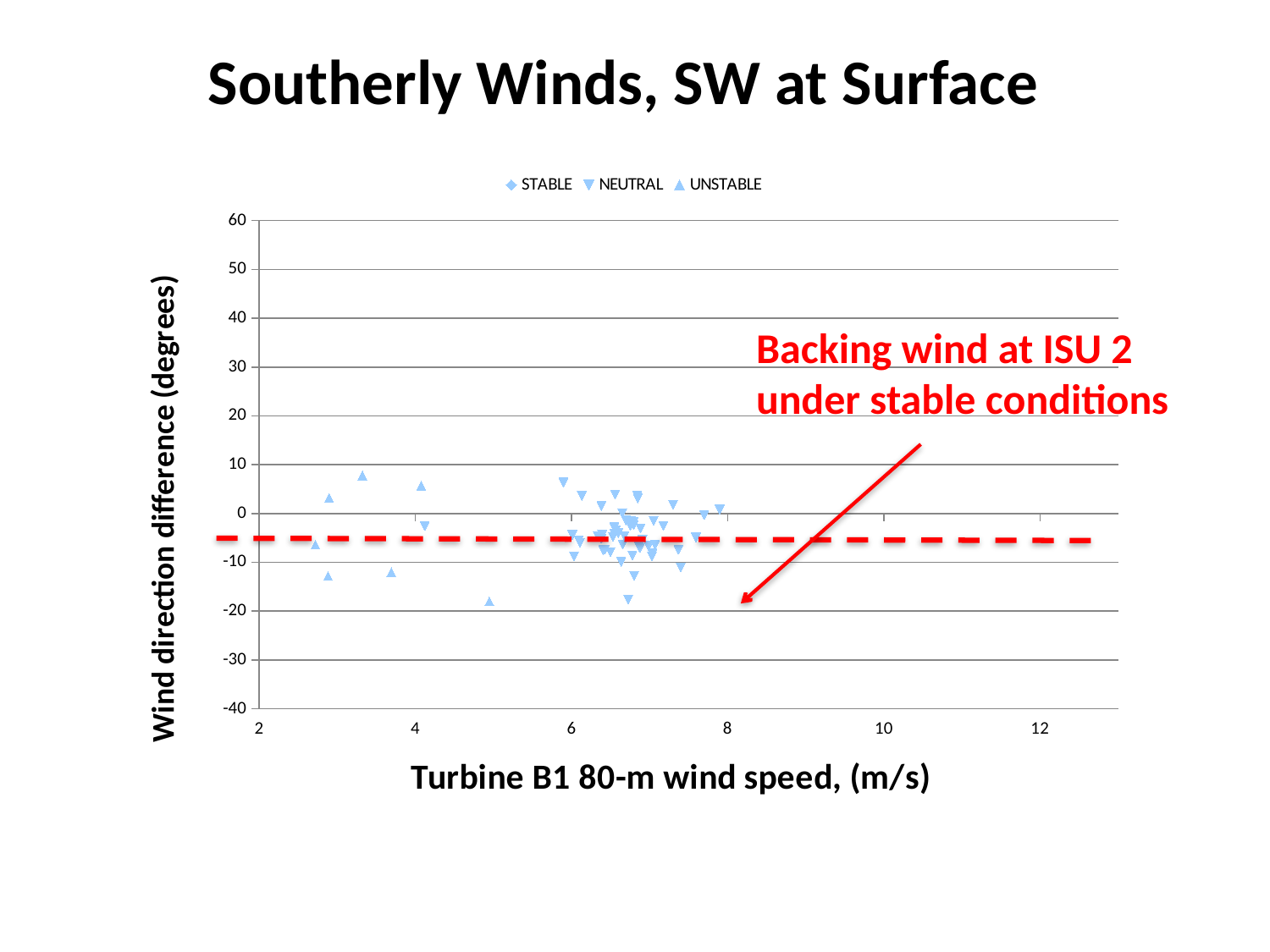
What are the three series named in the legend? STABLE, NEUTRAL, UNSTABLE Are any points plotted at a wind speed greater than 10 m/s? No Is the highest plotted wind direction difference greater or less than 0? greater What kind of chart is shown on the slide? scatter chart What is the title of the chart's x axis? Turbine B1 80-m wind speed, (m/s) Is the highest plotted wind direction difference greater or less than 10? less How many series does the legend list? 3